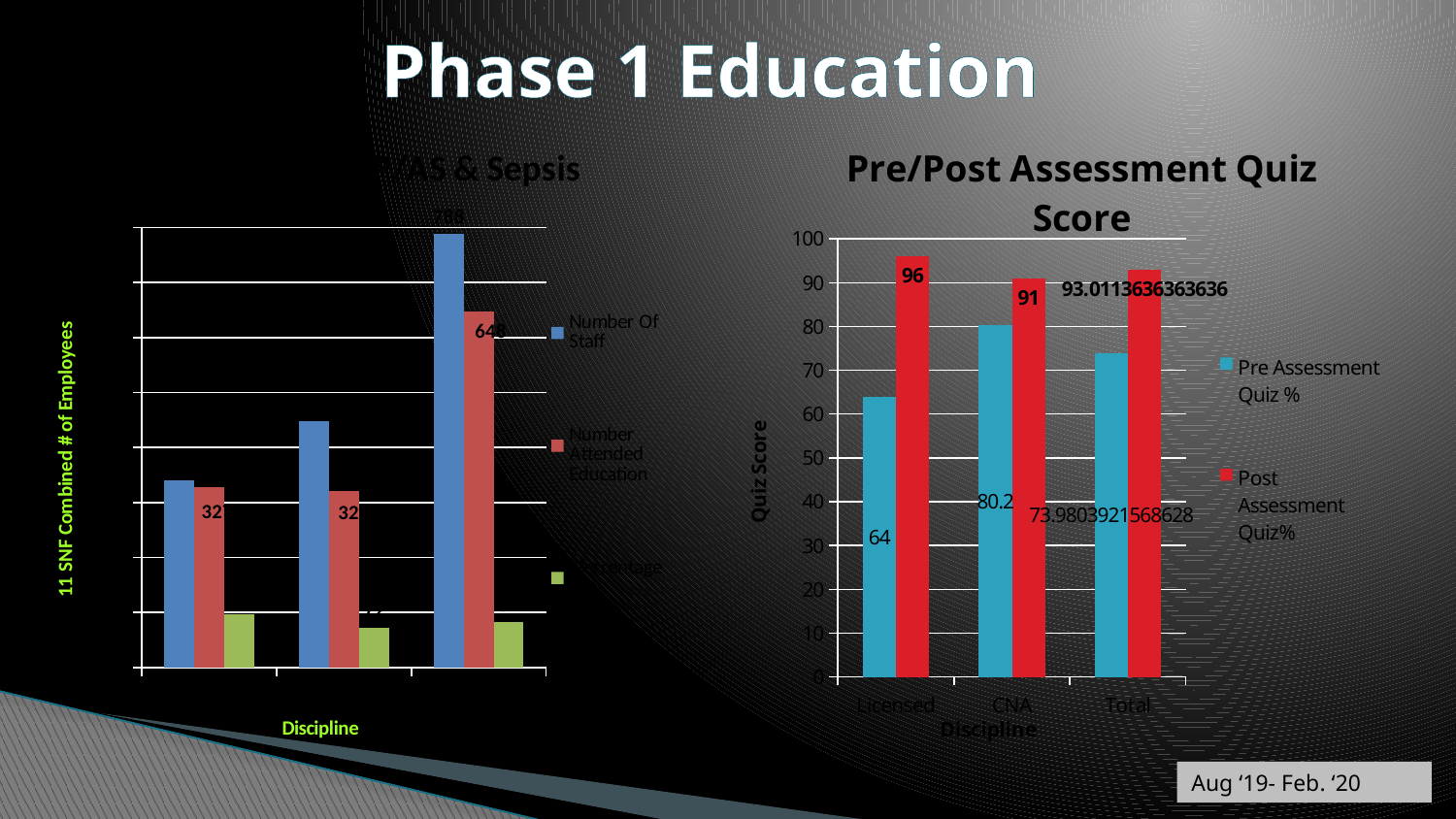
In the Pre/Post Assessment Quiz Score chart, what is the Post Assessment Quiz% for Total? 93.0113636363636 How many series does the legend of the Pre/Post Assessment Quiz Score chart list? 2 In the Pre/Post Assessment Quiz Score chart, what is the Post Assessment Quiz% for Licensed? 96 In the Pre/Post Assessment Quiz Score chart, what is the Post Assessment Quiz% for CNA? 91 In the Pre/Post Assessment Quiz Score chart, what is the Pre Assessment Quiz % for CNA? 80.2 How many series does the legend of the left chart (with y axis '11 SNF Combined # of Employees') list? 3 In the Pre/Post Assessment Quiz Score chart, is the Pre Assessment Quiz % higher for CNA or for Licensed? CNA In the Pre/Post Assessment Quiz Score chart, which discipline has the lowest Pre Assessment Quiz %? Licensed In the Pre/Post Assessment Quiz Score chart, what is the Pre Assessment Quiz % for Licensed? 64 How many disciplines are shown on the x axis of the Pre/Post Assessment Quiz Score chart? 3 In the Pre/Post Assessment Quiz Score chart, what is the difference between the Post and Pre Assessment Quiz values for Licensed? 32 In the Pre/Post Assessment Quiz Score chart, which discipline has the highest Post Assessment Quiz%? Licensed